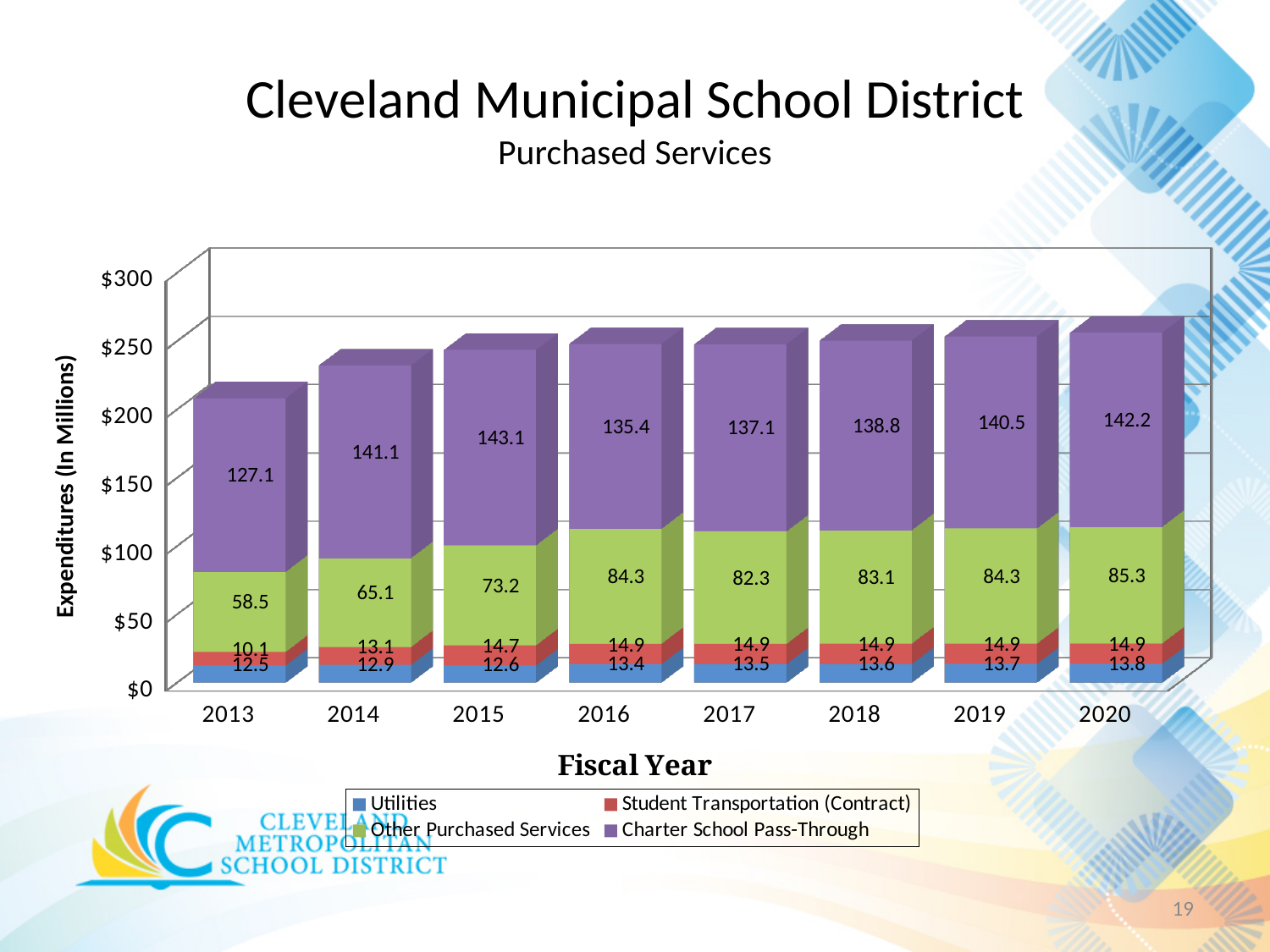
What is the total of the stacked bar for fiscal year 2013? 208.2 What is the Other Purchased Services value for fiscal year 2013? 58.5 Which fiscal year has the highest Charter School Pass-Through value? 2015 Which fiscal year has the lowest Other Purchased Services value? 2013 How many series does the legend list? 4 What is the Charter School Pass-Through value for fiscal year 2015? 143.1 What kind of chart is shown on the slide? Stacked bar chart What is the Utilities value for fiscal year 2020? 13.8 What is the difference between the Charter School Pass-Through values for 2020 and 2013? 15.1 What is the Student Transportation (Contract) value for fiscal year 2014? 13.1 How many fiscal years are shown on the x axis? 8 Which is larger, the Other Purchased Services value for 2016 or for 2017? 2016